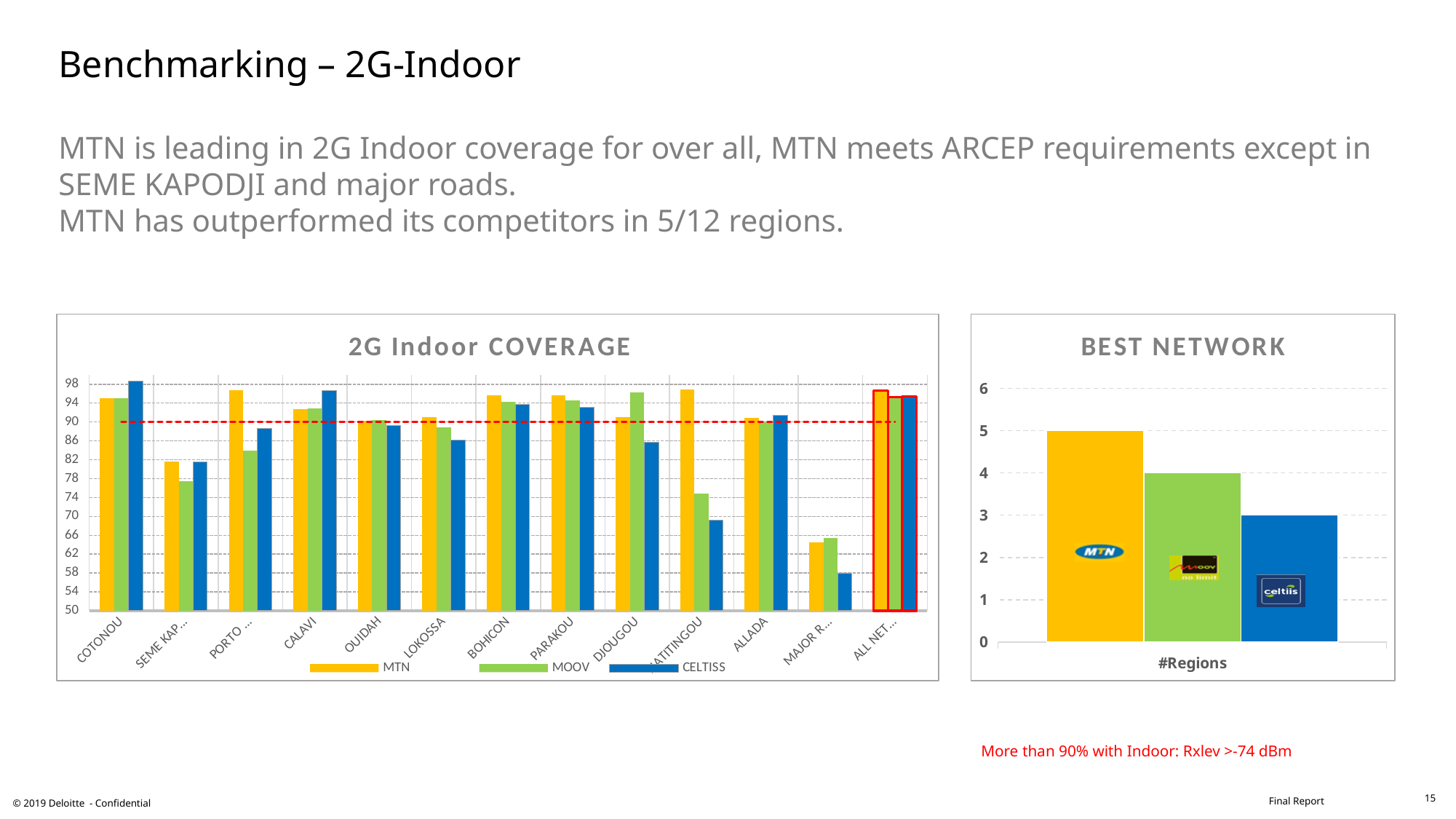
In the BEST NETWORK chart, which network has the highest number of regions? MTN In the 2G Indoor COVERAGE chart, for NATITINGOU, which is larger: the MTN value or the CELTISS value? MTN What kind of chart is the 2G Indoor COVERAGE chart? bar chart In the 2G Indoor COVERAGE chart, how many series does the legend list? 3 In the BEST NETWORK chart, what is the difference between the MTN value and the Celtiis value? 2 In the BEST NETWORK chart, what is the value for MTN? 5 In the 2G Indoor COVERAGE chart, how many categories are shown on the x axis? 13 In the 2G Indoor COVERAGE chart, which series has the highest value for COTONOU? CELTISS In the 2G Indoor COVERAGE chart, is the CELTISS value for COTONOU greater or less than 94? greater In the BEST NETWORK chart, what is the value for Celtiis? 3 In the 2G Indoor COVERAGE chart, is the CELTISS value for NATITINGOU greater or less than 74? less What is the x-axis label of the BEST NETWORK chart? #Regions